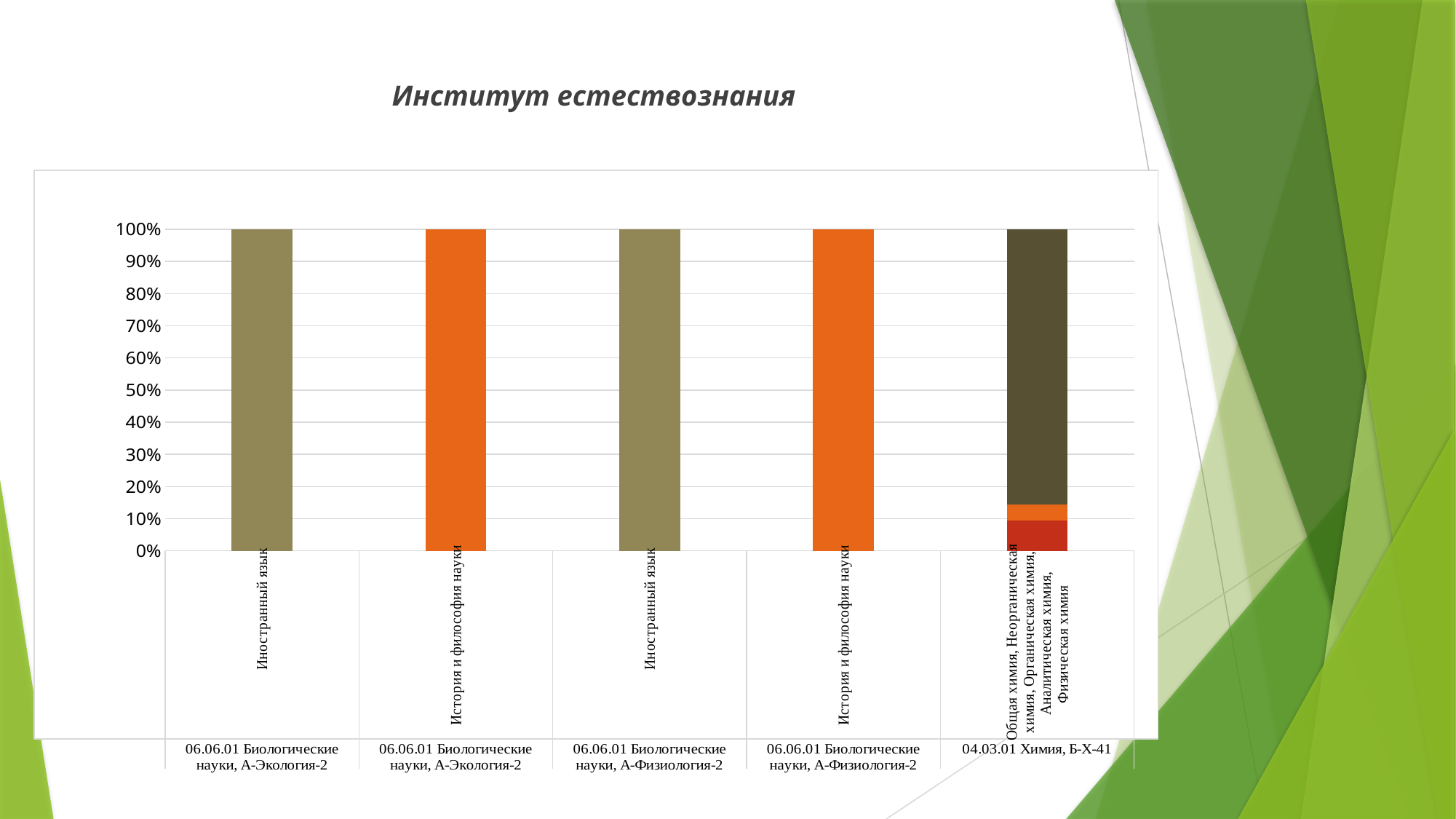
Which is larger in the bar for 04.03.01 Химия, Б-Х-41: the dark olive segment or the dark red segment? The dark olive segment What value does the bar for Иностранный язык under 06.06.01 Биологические науки, А-Экология-2 reach? 100% How many bars are plotted in the chart? 5 Is the bottom (dark red) segment of the bar for 04.03.01 Химия, Б-Х-41 greater or less than 20%? less Is the top (dark olive) segment of the bar for 04.03.01 Химия, Б-Х-41 greater or less than 80%? greater What is the highest value shown on the vertical axis? 100% What is the title of the slide? Институт естествознания Is the combined height of the two lower segments (dark red and orange) of the bar for 04.03.01 Химия, Б-Х-41 greater or less than 20%? less What is the total height of the stacked bar for 04.03.01 Химия, Б-Х-41? 100% What kind of chart is shown on the slide? Stacked bar chart What value does the bar for История и философия науки under 06.06.01 Биологические науки, А-Физиология-2 reach? 100% How many coloured segments make up the bar for 04.03.01 Химия, Б-Х-41? 3